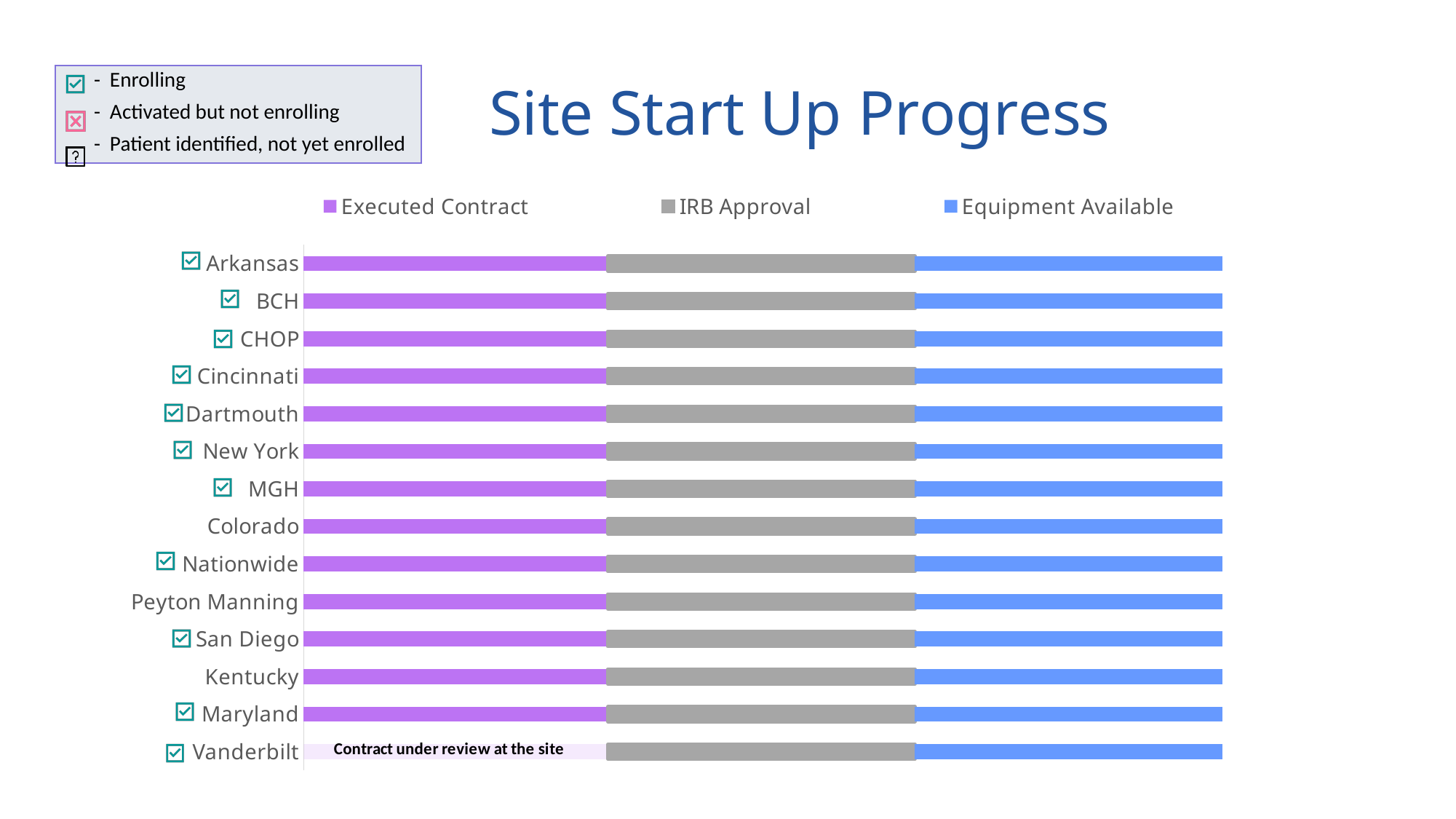
What kind of chart is shown on the slide? Stacked bar chart Which series is shown in grey in the chart legend? IRB Approval Which site is listed first (at the top) on the chart's category axis? Arkansas Which site's Executed Contract segment is replaced by the note 'Contract under review at the site'? Vanderbilt What is the title of the chart on the slide? Site Start Up Progress Which series is shown in purple in the chart legend? Executed Contract How many series does the chart legend list? 3 How many sites are listed on the chart's category axis? 14 Which site is listed last (at the bottom) on the chart's category axis? Vanderbilt